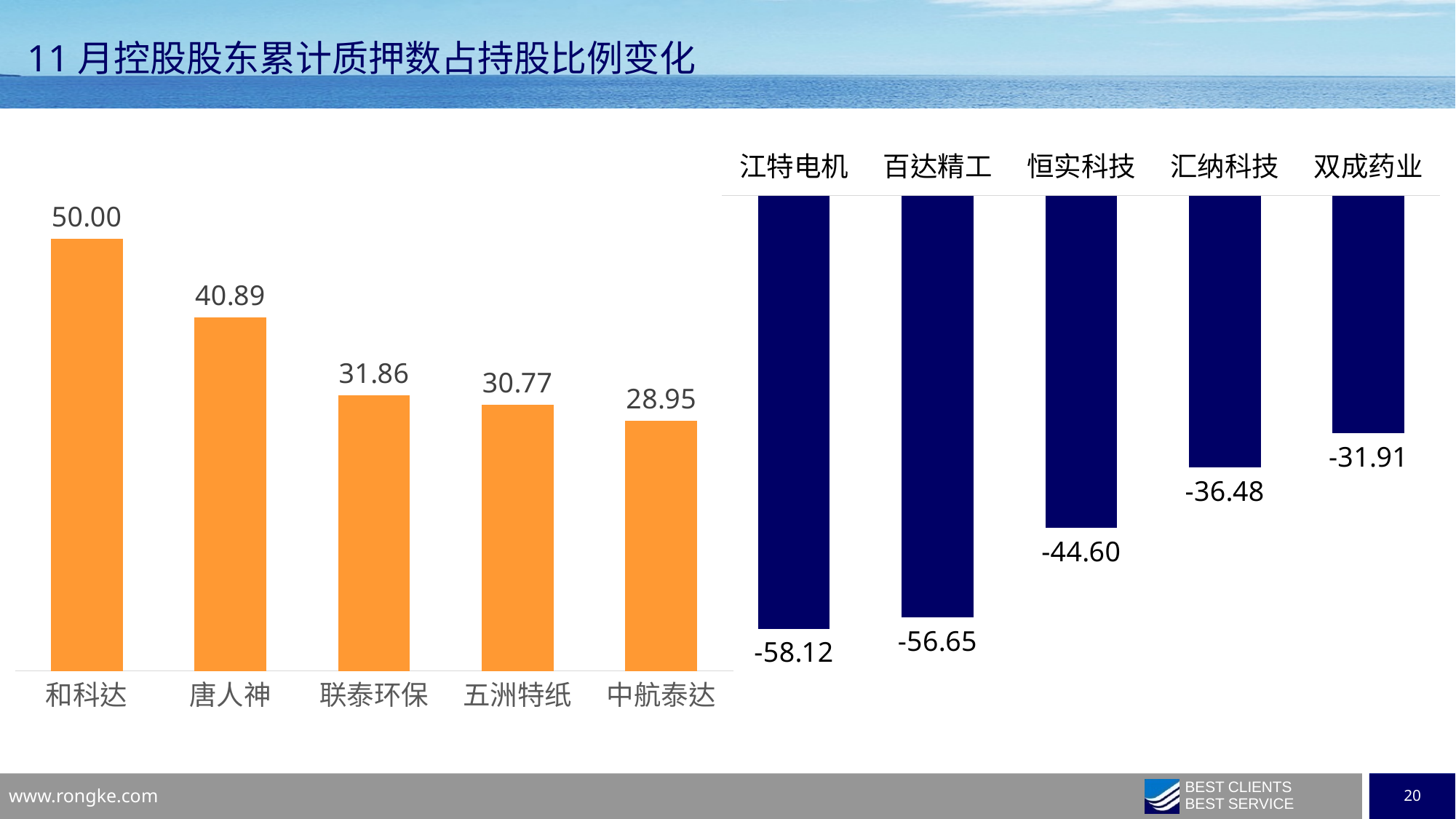
In the right chart with dark blue bars, which category has the lowest (most negative) value? 江特电机 In the right chart with dark blue bars, what is the value for 恒实科技? -44.60 In the left chart with orange bars, which is larger, the value for 唐人神 or the value for 五洲特纸? 唐人神 How many categories are shown in the right chart with dark blue bars? 5 What kind of chart is the left chart with orange bars? Bar chart In the left chart with orange bars, which category has the lowest value? 中航泰达 In the left chart with orange bars, what is the difference between the values for 和科达 and 唐人神? 9.11 In the left chart with orange bars, what is the value for 联泰环保? 31.86 In the right chart with dark blue bars, what is the value for 双成药业? -31.91 In the left chart with orange bars, what is the value for 和科达? 50.00 In the right chart with dark blue bars, what is the difference between the values for 汇纳科技 and 双成药业? 4.57 In the left chart with orange bars, do the values rise or fall from left to right? Fall